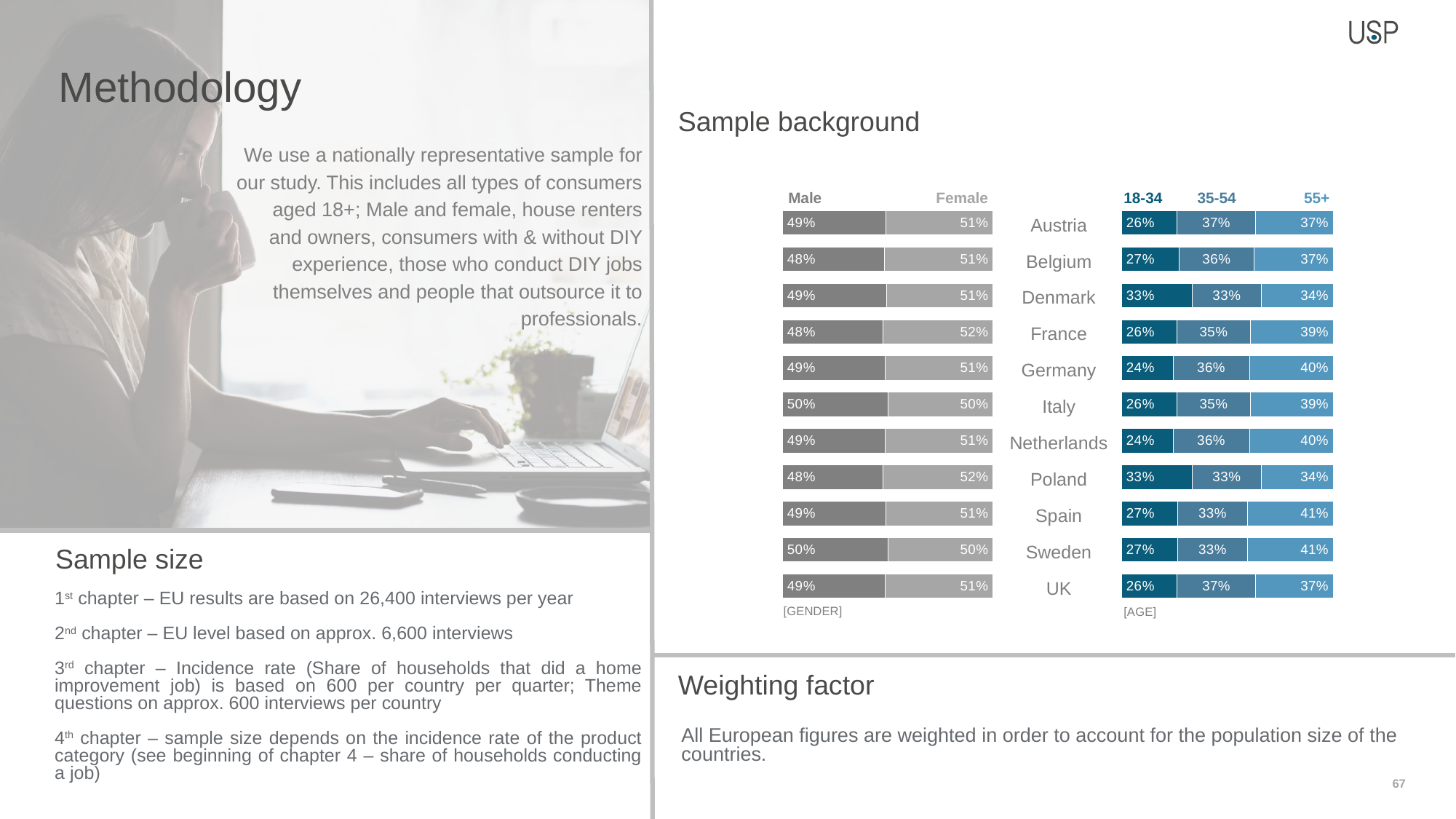
In the gender chart, how much larger is the Female share than the Male share for Poland? 4% In the age chart, what is the total of the three age group shares for Denmark? 100% In the gender chart, what is the Female share for Belgium? 51% What kind of chart is used for the gender breakdown? Bar chart In the age chart, which age group has the largest share for Germany? 55+ How many countries are listed in the Sample background charts? 11 In the age chart, what is the 55+ share for Spain? 41% In the age chart, what is the 18-34 share for Germany? 24% What label appears beneath the gender chart? [GENDER] In the age chart, which has the larger 55+ share, Germany or Austria? Germany How many age groups does the age chart show? 3 In the gender chart, what is the Male share for France? 48%